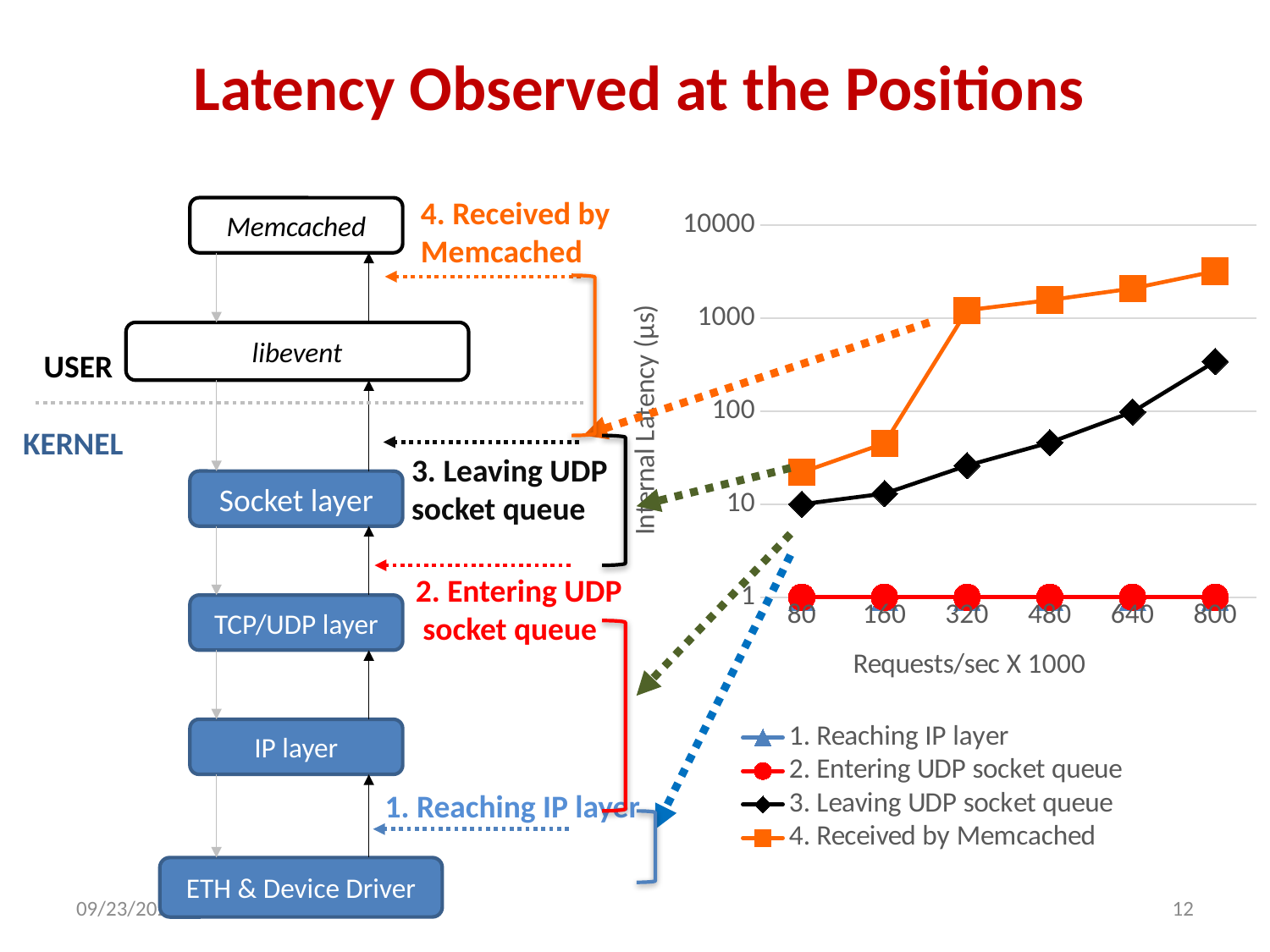
What kind of chart is shown on the slide? line chart What is the y-axis title of the chart? Internal Latency (µs) What is the x-axis title of the chart? Requests/sec X 1000 Is the value for '4. Received by Memcached' at 160 greater or less than 100? less How many series does the chart legend list? 4 Is the value for '3. Leaving UDP socket queue' at 800 greater or less than 100? greater How many request-rate points are shown along the x axis of the chart? 6 Does the latency for '4. Received by Memcached' rise or fall as requests/sec increases? rise Which series shows the highest latency at 800 requests/sec x 1000? 4. Received by Memcached At 800 requests/sec x 1000, which series has the higher latency: '3. Leaving UDP socket queue' or '4. Received by Memcached'? 4. Received by Memcached Is the value for '3. Leaving UDP socket queue' at 320 greater or less than 100? less